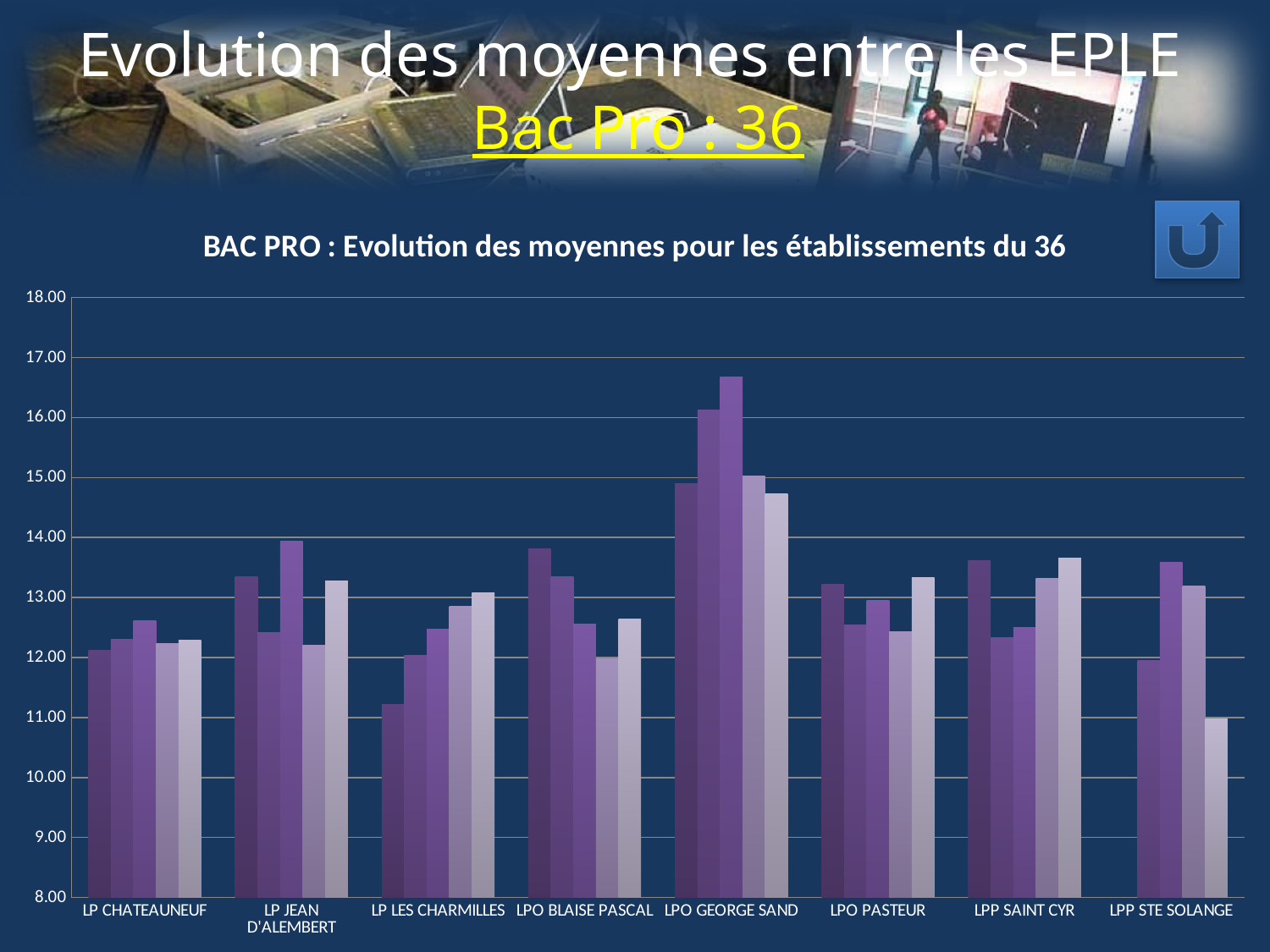
How many bars are plotted for each establishment in the chart? 5 (LPP STE SOLANGE has only 4) Is the tallest bar for LP CHATEAUNEUF greater or less than 13.00? less Is the tallest bar for LPP SAINT CYR greater or less than 14.00? less Is the shortest bar for LP LES CHARMILLES greater or less than 12.00? less Which has the taller highest bar: LPO GEORGE SAND or LPO PASTEUR? LPO GEORGE SAND What is the title of the chart? BAC PRO : Evolution des moyennes pour les établissements du 36 Which establishment has the highest bar in the chart? LPO GEORGE SAND What kind of chart is shown on the slide? bar chart What is the lowest value shown on the y axis of the chart? 8.00 How many establishments (categories) are shown on the x axis of the chart? 8